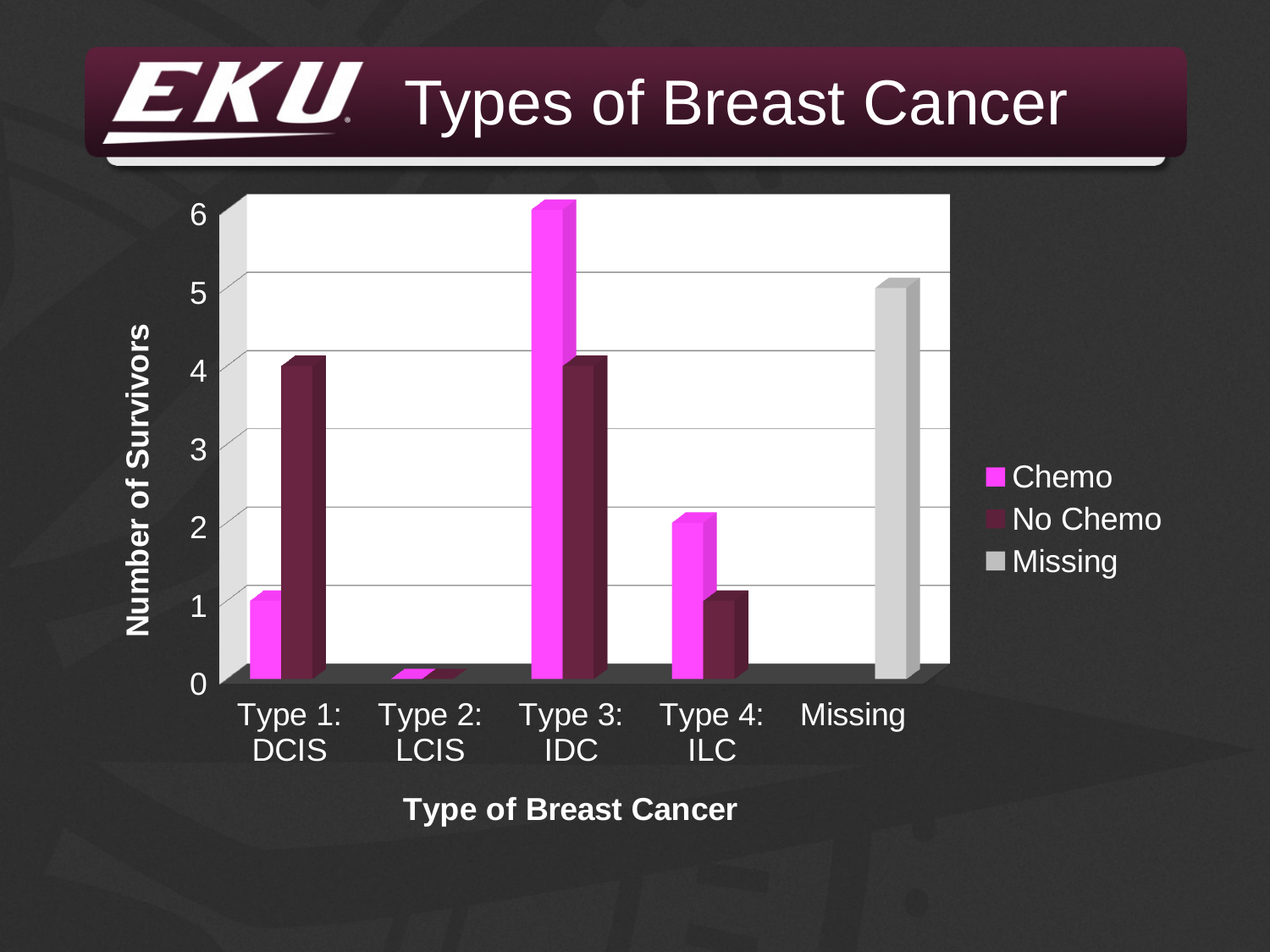
How many categories are shown on the x axis? 5 How many series does the legend list? 3 Which type of breast cancer has the lowest No Chemo value? Type 2: LCIS Which is larger for Type 1: DCIS, Chemo or No Chemo? No Chemo What is the label of the y axis? Number of Survivors Is the Chemo value for Type 4: ILC greater or less than 3? less Which type of breast cancer has the highest Chemo value? Type 3: IDC What is the number of survivors for Missing? 5 What is the difference between the Chemo and No Chemo values for Type 3: IDC? 2 What kind of chart is shown on the slide? bar chart What is the number of survivors for Chemo in Type 3: IDC? 6 What is the number of survivors for No Chemo in Type 1: DCIS? 4